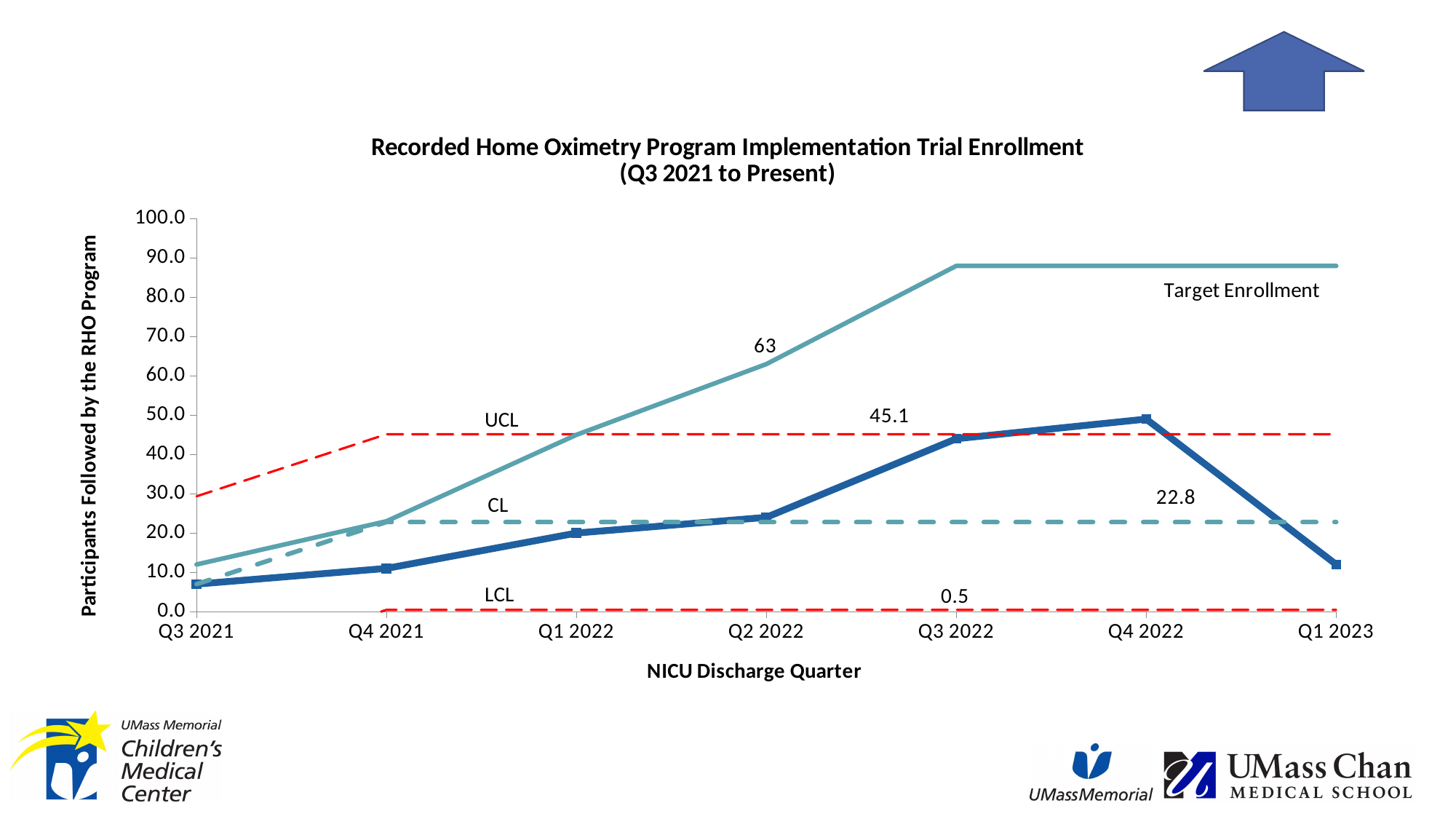
How many NICU discharge quarters are shown on the x axis? 7 Is the Target Enrollment value at Q1 2023 greater or less than 80? greater What is the title of the x axis? NICU Discharge Quarter What is the value of the CL line? 22.8 What kind of chart is shown on the slide? line chart What is the labelled Target Enrollment value at Q2 2022? 63 What is the value of the LCL line? 0.5 In which quarter is the number of participants followed by the RHO Program highest? Q4 2022 Is the number of participants followed by the RHO Program in Q4 2022 greater or less than 40? greater In which quarter is the number of participants followed by the RHO Program lowest? Q3 2021 What is the difference between the UCL value and the CL value? 22.3 What is the value of the UCL line? 45.1